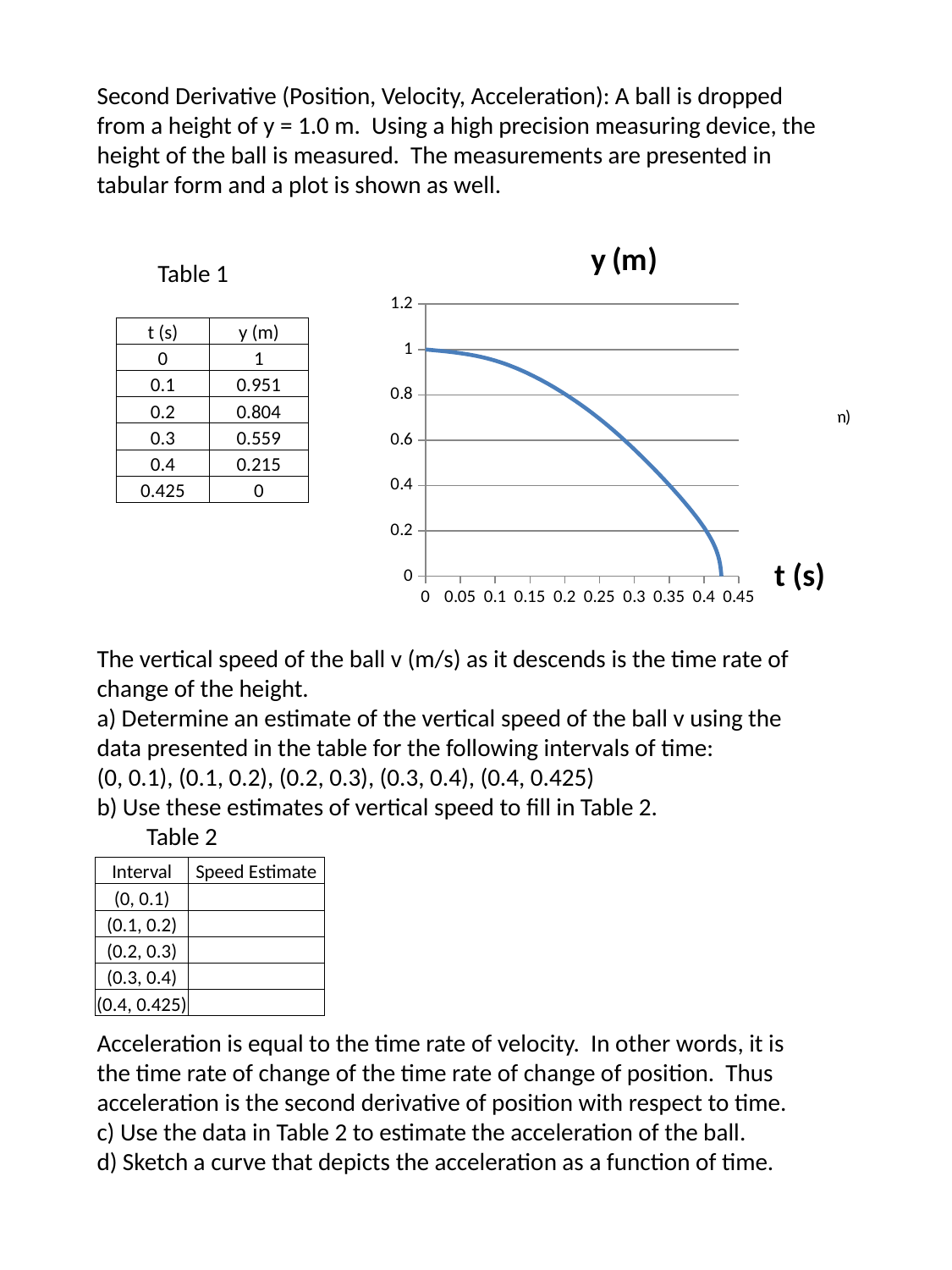
What is the value of y (m) at t = 0.3 s? 0.559 What label is shown on the x axis of the chart? t (s) What is the title of the chart? y (m) Which is larger, the value of y at t = 0.1 s or at t = 0.3 s? t = 0.1 s Does the plotted height y rise or fall as t increases along the x axis? fall What kind of chart is shown on the slide? line chart Is the value of y at t = 0.1 s greater or less than 0.8? greater At which value of t is the plotted height y lowest? 0.425 Is the value of y at t = 0.4 s greater or less than 0.4? less What is the value of y (m) at t = 0.425 s? 0 What is the value of y (m) at t = 0 s? 1 At which value of t is the plotted height y highest? 0